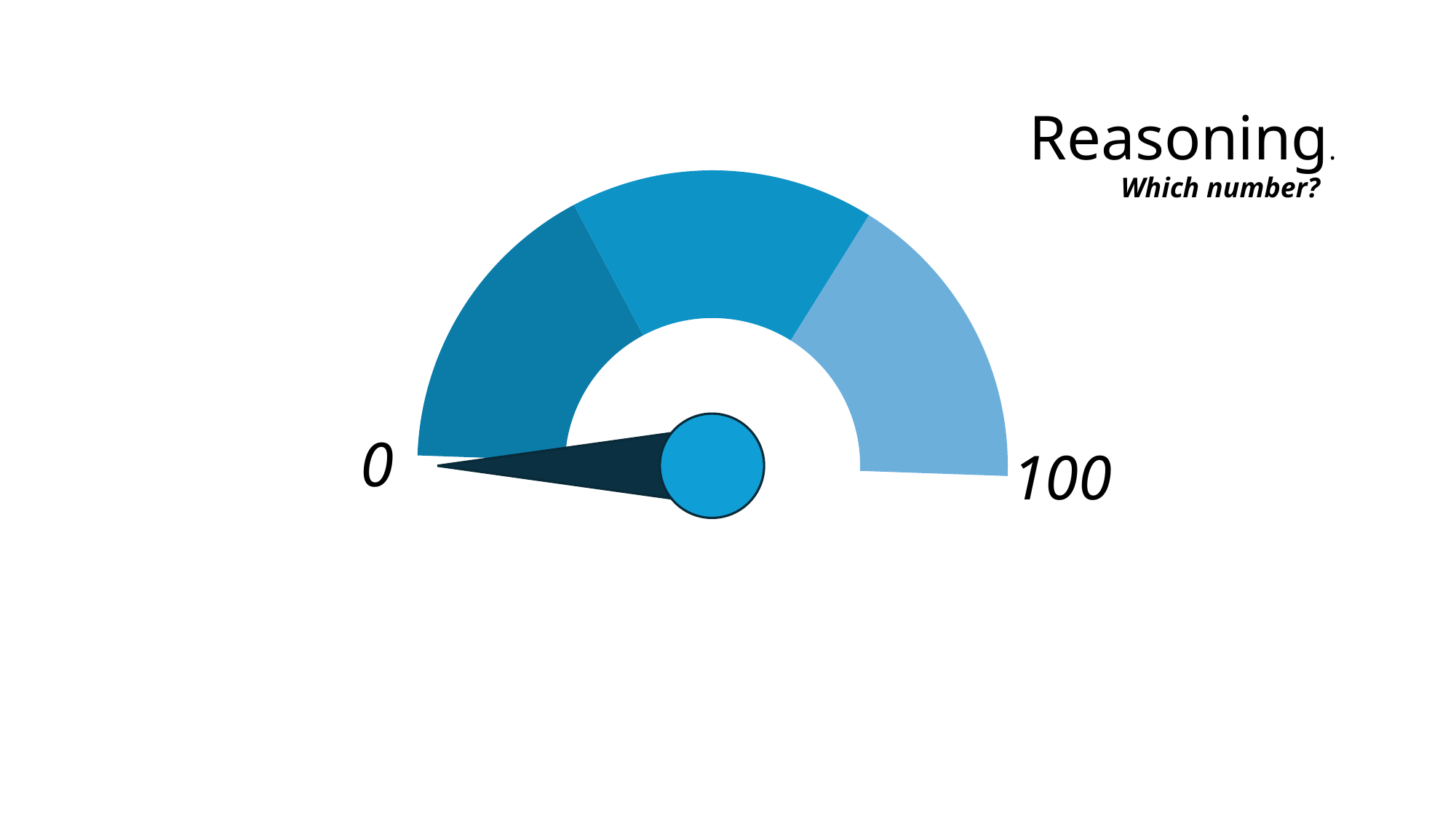
What question is written beneath the title? Which number? What is the lowest value labelled on the gauge scale? 0 What is the title text shown on the slide? Reasoning. Is the value the needle points to greater or less than 50? less How many coloured segments make up the gauge arc? 3 What is the highest value labelled on the gauge scale? 100 Which end of the scale is the needle pointing toward, 0 or 100? 0 What kind of chart is shown on the slide? gauge chart